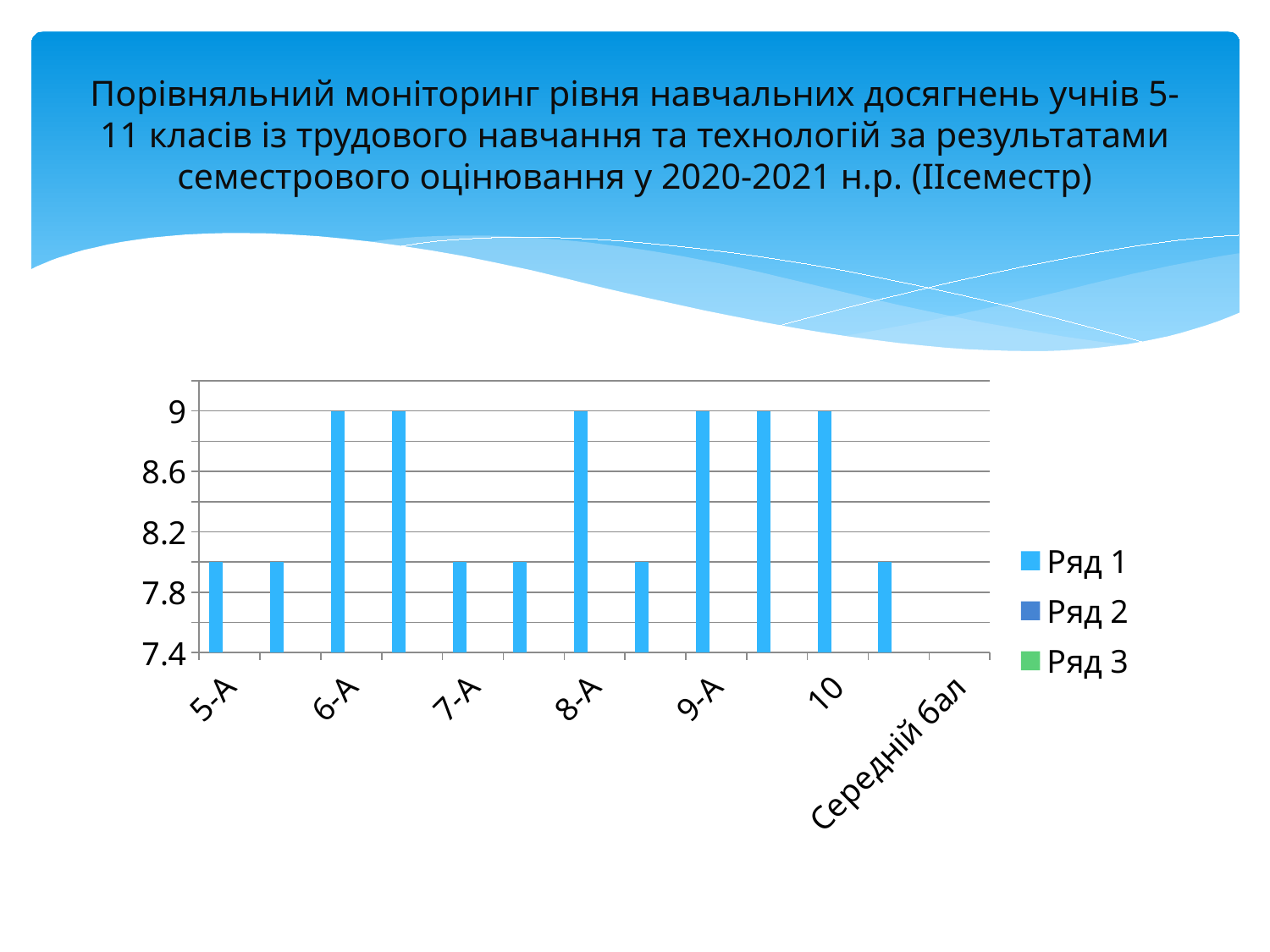
What is the value for 6-А? 9 Which is larger, the value for 7-А or the value for 8-А? 8-А Is the value for 5-А greater or less than 8.2? less What is the value for 9-А? 9 What is the value for 10? 9 Is the value for 7-А greater or less than 7.8? greater What kind of chart is shown on the slide? bar chart What is the value for 8-А? 9 What is the lowest value printed on the vertical axis? 7.4 How many series does the legend list? 3 Which is larger, the value for 5-А or the value for 6-А? 6-А What is the name of the first series in the legend? Ряд 1